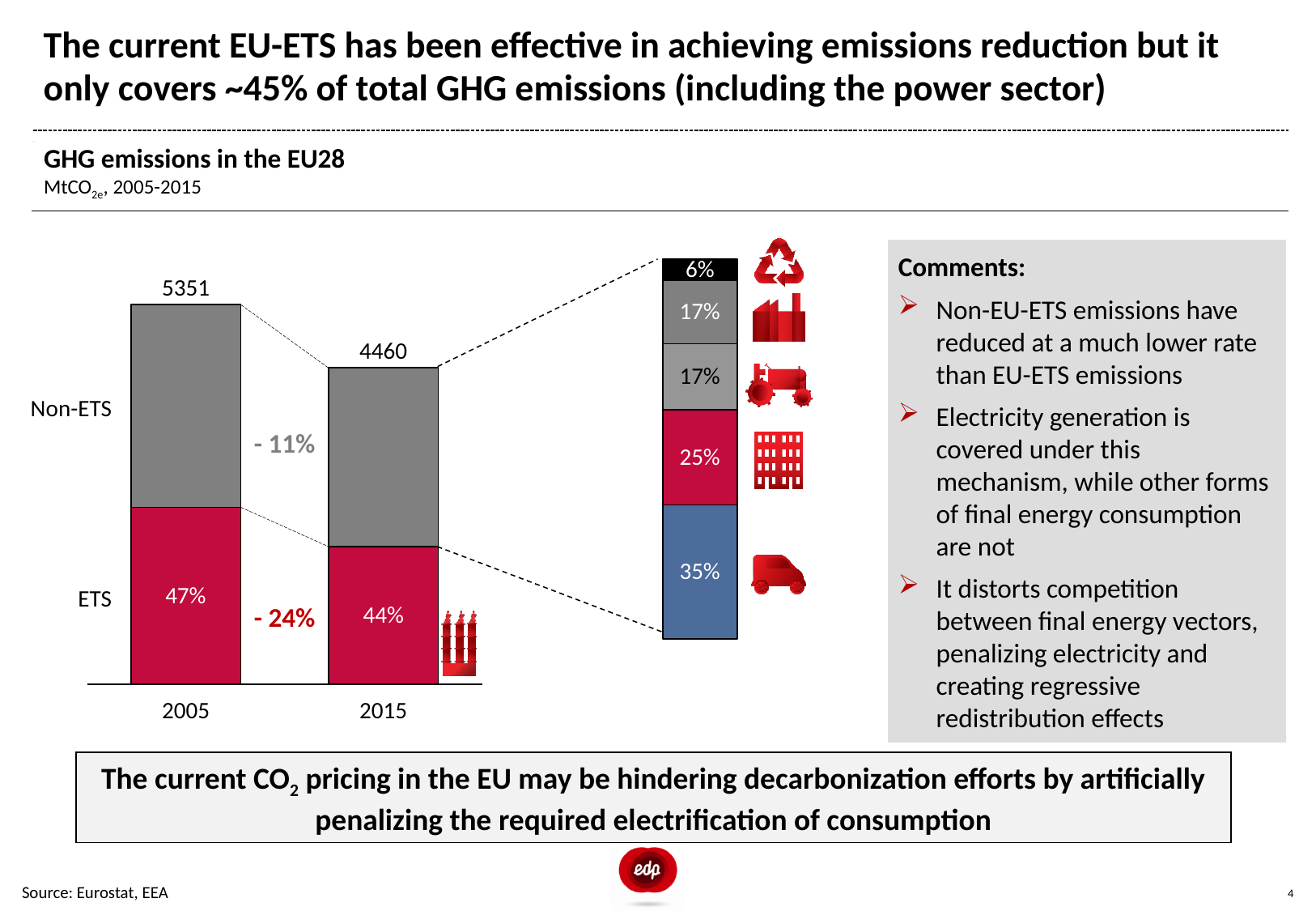
What is the total GHG emissions value shown for 2005 in the 'GHG emissions in the EU28' chart? 5351 Which year has the higher total GHG emissions, 2005 or 2015? 2005 What share of total emissions did ETS account for in 2005? 47% What is the difference between the total emissions in 2005 and 2015? 891 Do total GHG emissions rise or fall from 2005 to 2015? fall By what percentage did Non-ETS emissions change between 2005 and 2015, according to the chart? - 11% What kind of chart is used to show GHG emissions in the EU28? stacked bar chart In the breakdown bar of 2015 Non-ETS emissions, what is the largest segment's share? 35% How many years are shown on the x axis of the stacked bar chart? 2 What share of total emissions did ETS account for in 2015? 44% By what percentage did ETS emissions change between 2005 and 2015, according to the chart? - 24% What is the total GHG emissions value shown for 2015 in the 'GHG emissions in the EU28' chart? 4460